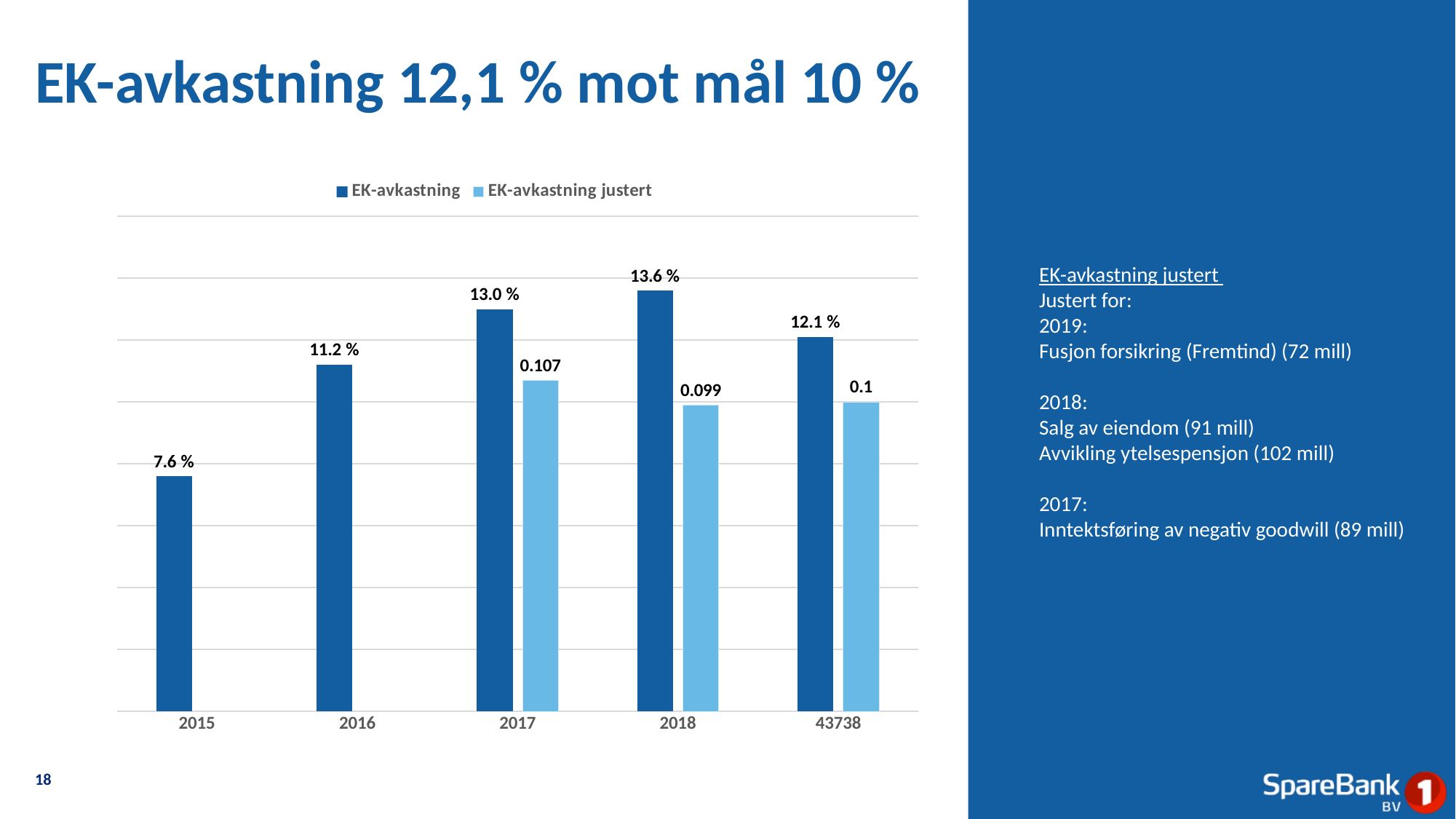
What is the EK-avkastning value for 2018? 13.6 % What is the difference between the EK-avkastning values for 2018 and 2015? 6.0 % Does the EK-avkastning series rise or fall from 2015 to 2018? rise Which category has the lowest EK-avkastning value? 2015 What is the EK-avkastning justert value for the category labelled 43738? 0.1 What is the EK-avkastning justert value for 2017? 0.107 What type of chart is shown on the slide? bar chart How many categories are shown on the x axis? 5 Which category has the highest EK-avkastning value? 2018 How many series does the legend list? 2 Which is larger, the EK-avkastning value for 2016 or for 2017? 2017 What is the EK-avkastning value for 2015? 7.6 %